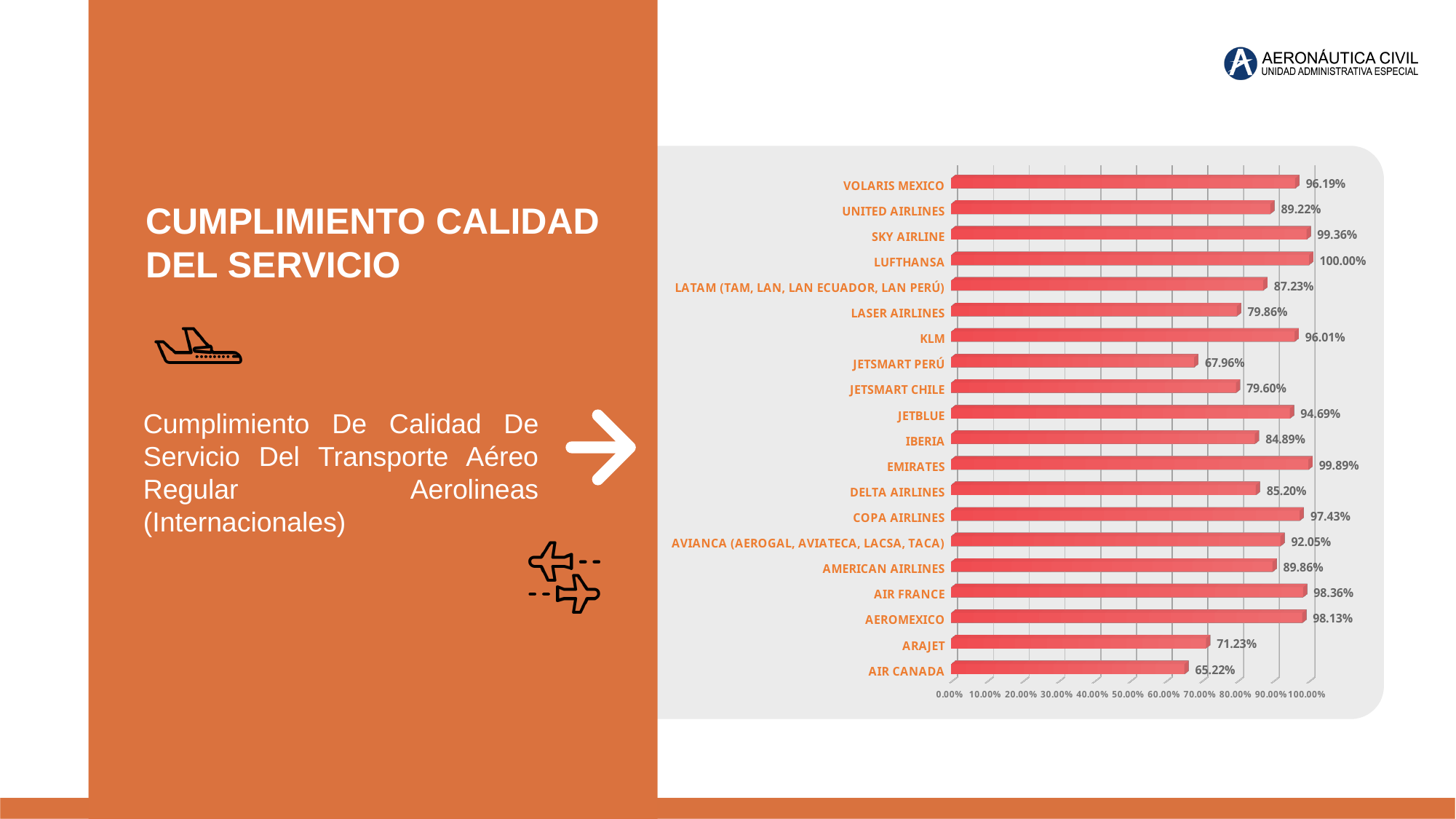
How many airlines are shown in the chart? 20 What is the value for JETSMART PERÚ? 67.96% What is the value for COPA AIRLINES? 97.43% What is the value for AVIANCA (AEROGAL, AVIATECA, LACSA, TACA)? 92.05% What kind of chart is shown on the slide? bar chart Is the value for AIR CANADA greater or less than 70.00%? less What is the value for LUFTHANSA? 100.00% What is the difference between the values for LUFTHANSA and AIR CANADA? 34.78% What is the difference between the values for COPA AIRLINES and DELTA AIRLINES? 12.23% Which airline has the lowest value? AIR CANADA Which has a larger value, KLM or JETSMART PERÚ? KLM Which airline has the highest value? LUFTHANSA